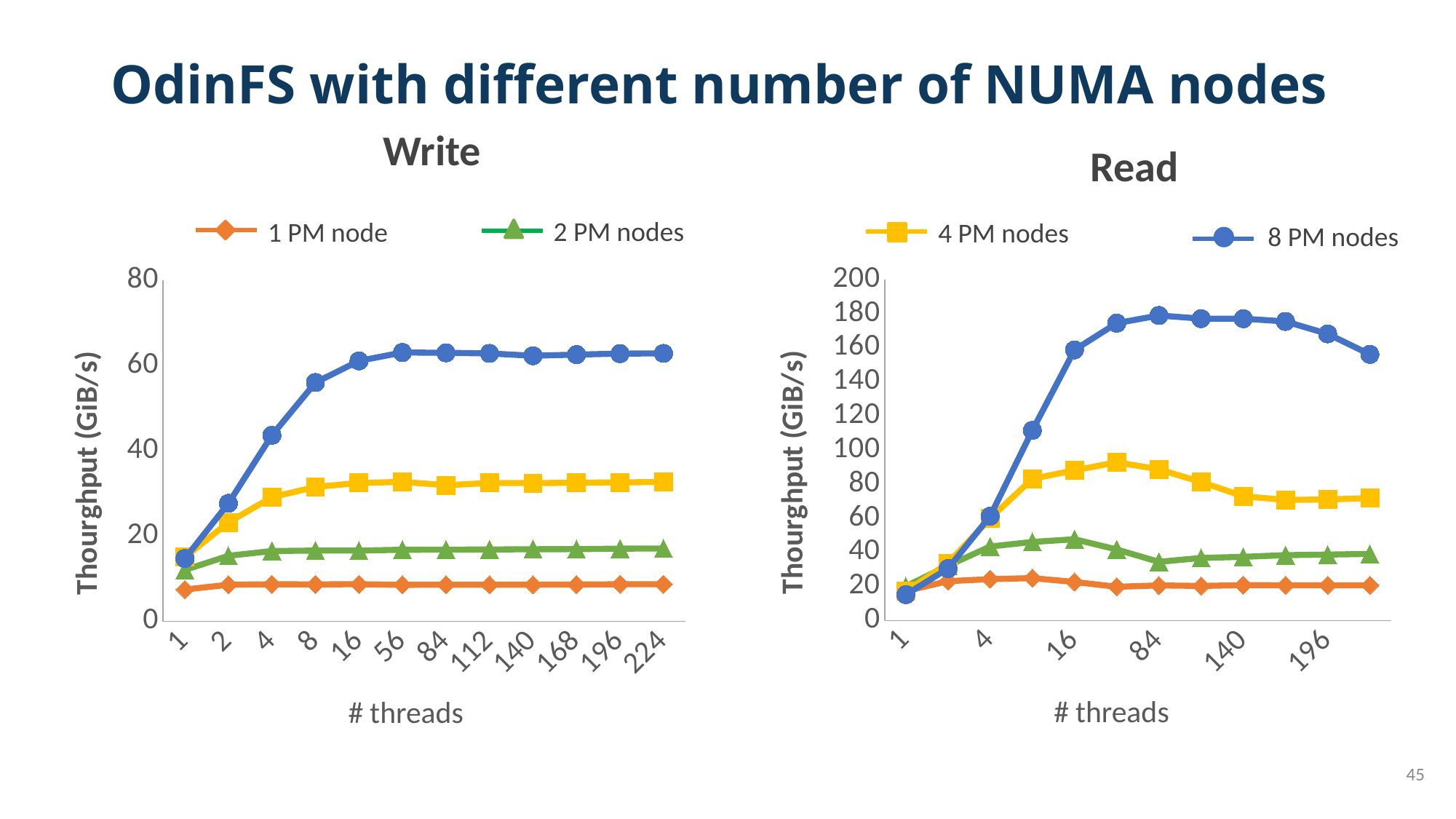
In the Write chart, is the value for 1 PM node at 224 threads greater or less than 20? less What is the x-axis label of the Read chart? # threads In the Write chart, is the value for 8 PM nodes at 224 threads greater or less than 40? greater How many thread counts are plotted along the x axis of the Write chart? 12 How many series does the legend on the slide list? 4 In the Write chart, which series has the highest throughput at 224 threads? 8 PM nodes In the Read chart, is the value for 4 PM nodes at 196 threads greater or less than 100? less In the Read chart, does the 8 PM nodes series rise or fall from 1 thread to 16 threads? rise What kind of chart is the Write chart? line chart In the Read chart at 16 threads, which is larger: 4 PM nodes or 2 PM nodes? 4 PM nodes In the Write chart, which series has the lowest throughput at 224 threads? 1 PM node